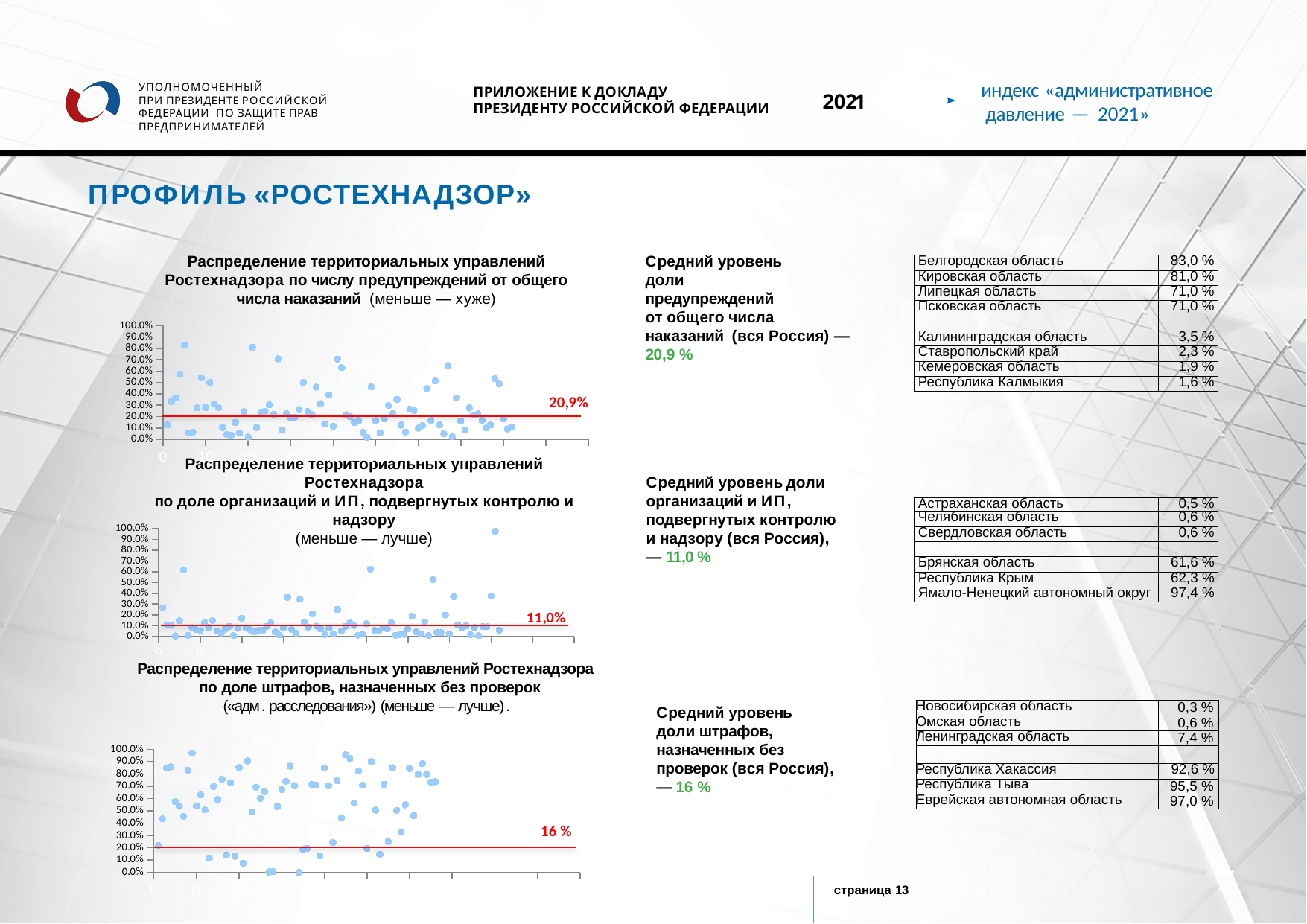
How many scatter charts are shown on the slide? 3 What colour is the horizontal average line in each of the three charts? red Is the red average line in the top chart on warnings greater or less than 10.0% on the y axis? greater In the middle chart on the share of organisations and sole proprietors subjected to control, what value is printed next to the red horizontal line? 11,0% What is the maximum value shown on the y axis of the top chart? 100.0% Is the red average line in the bottom chart on fines without inspections greater or less than 20.0% on the y axis? less What kind of chart is the top chart, 'Распределение территориальных управлений Ростехнадзора по числу предупреждений от общего числа наказаний'? scatter chart Which chart has the highest red average line value: the top, middle or bottom chart? top chart In the top chart on the number of warnings, what value is printed next to the red horizontal line? 20,9% What is the difference between the red line value in the top chart (20,9%) and the red line value in the middle chart (11,0%)? 9,9% In the bottom chart on the share of fines imposed without inspections, what value is printed next to the red horizontal line? 16 % Which chart has the lowest red average line value: the top, middle or bottom chart? middle chart